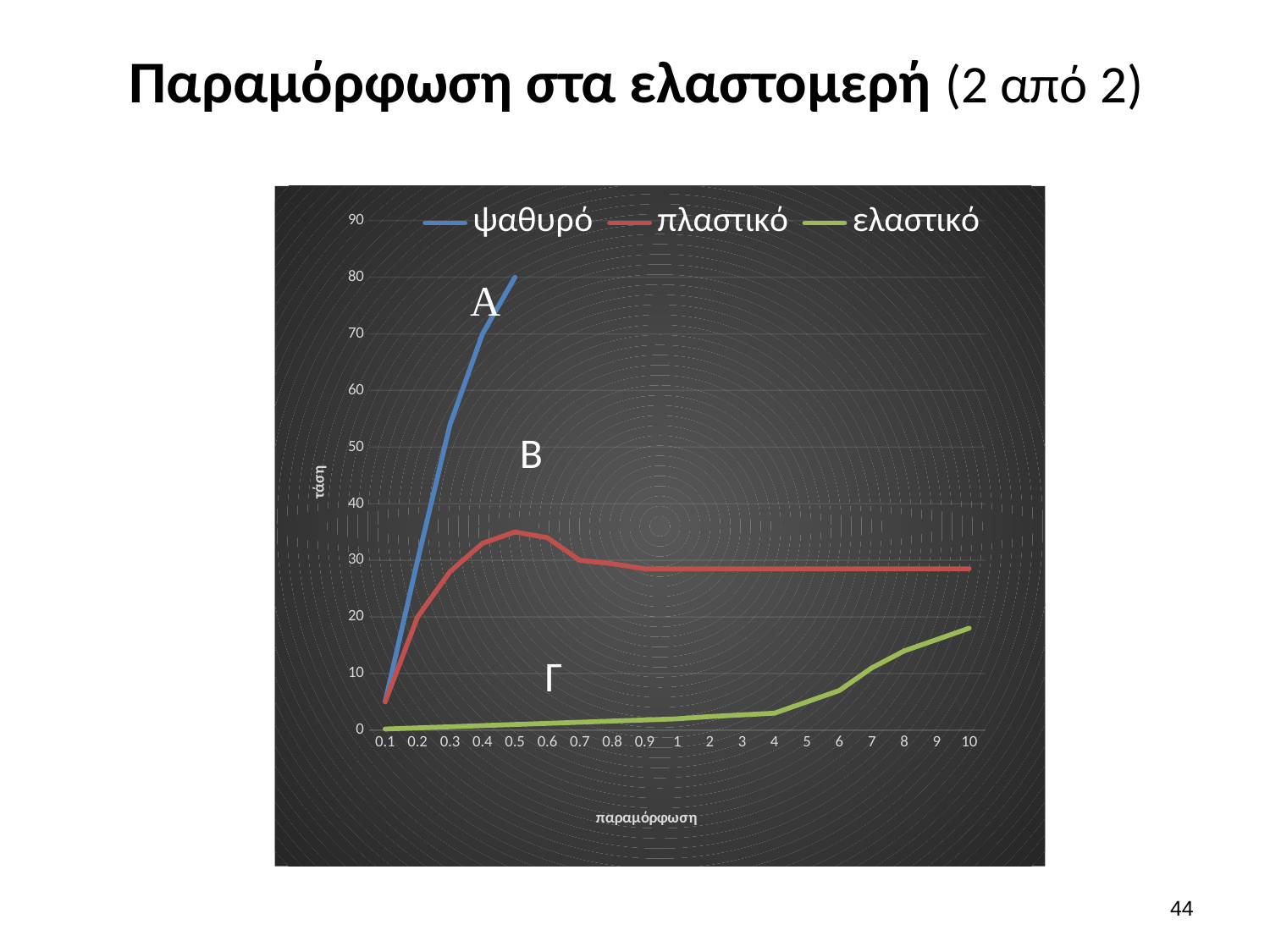
At 10, which series has the larger value, πλαστικό or ελαστικό? πλαστικό What is the label of the vertical axis? τάση How many series does the legend list? 3 What kind of chart is shown on the slide? line chart Does the ελαστικό series rise or fall along the x axis? rise Which series reaches the highest value on the chart? ψαθυρό Is the value for ψαθυρό at 0.5 greater or less than 70? greater How many categories are shown on the x axis? 19 Is the value for πλαστικό at 0.5 greater or less than 30? greater Is the value for ελαστικό at 4 greater or less than 10? less At 0.5, which series has the larger value, ψαθυρό or πλαστικό? ψαθυρό